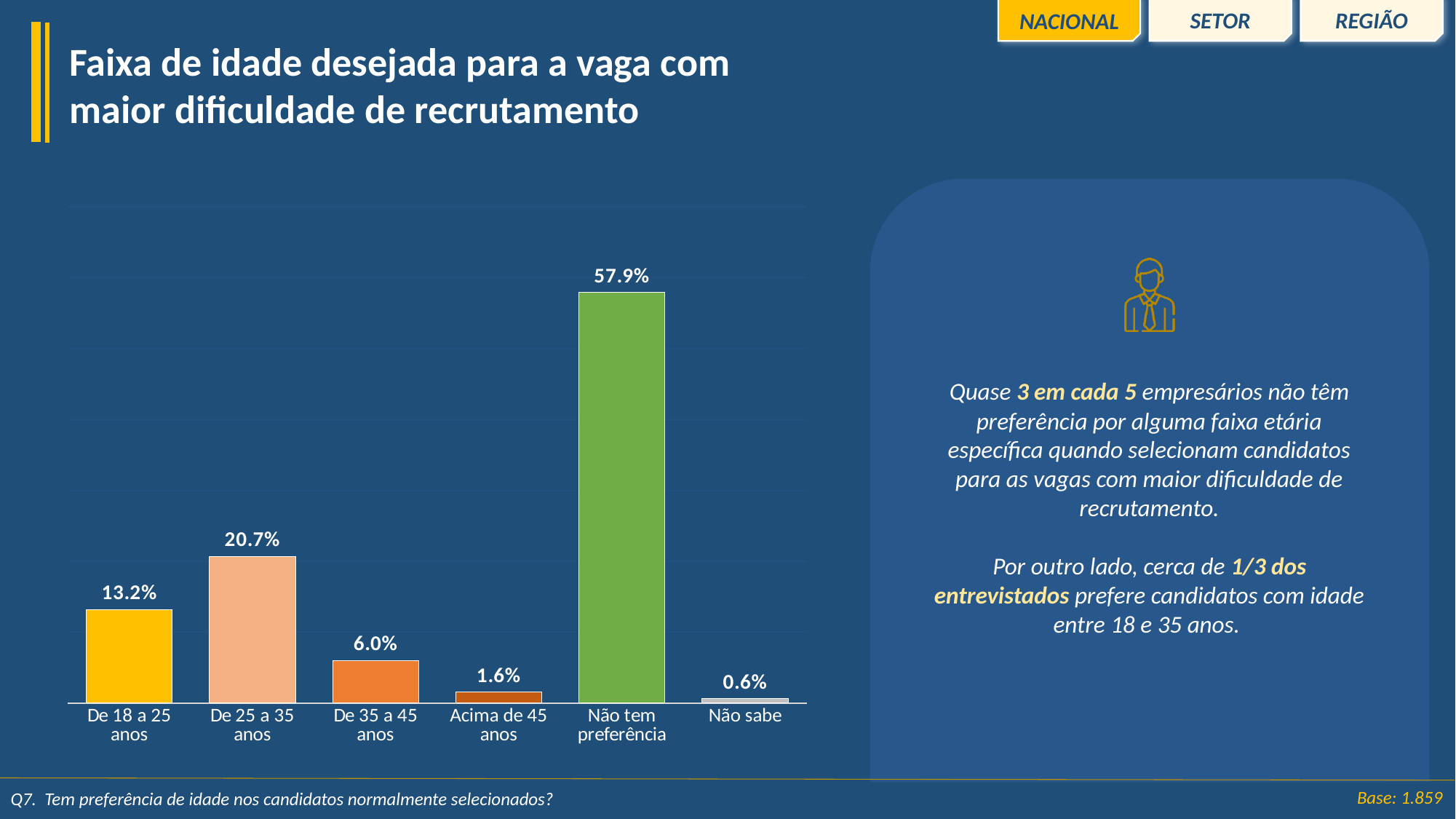
What is the difference between "Não tem preferência" and "De 25 a 35 anos"? 37.2% Which is larger, "De 35 a 45 anos" or "Acima de 45 anos"? De 35 a 45 anos What kind of chart is shown on the slide? Bar chart What is the value for "De 18 a 25 anos"? 13.2% What is the difference between "De 25 a 35 anos" and "De 18 a 25 anos"? 7.5% Which category has the highest value? Não tem preferência What is the value for "Acima de 45 anos"? 1.6% What is the value for "Não tem preferência"? 57.9% Which category has the lowest value? Não sabe What is the title of the slide? Faixa de idade desejada para a vaga com maior dificuldade de recrutamento What is the value for "De 25 a 35 anos"? 20.7% How many categories are shown in the chart? 6